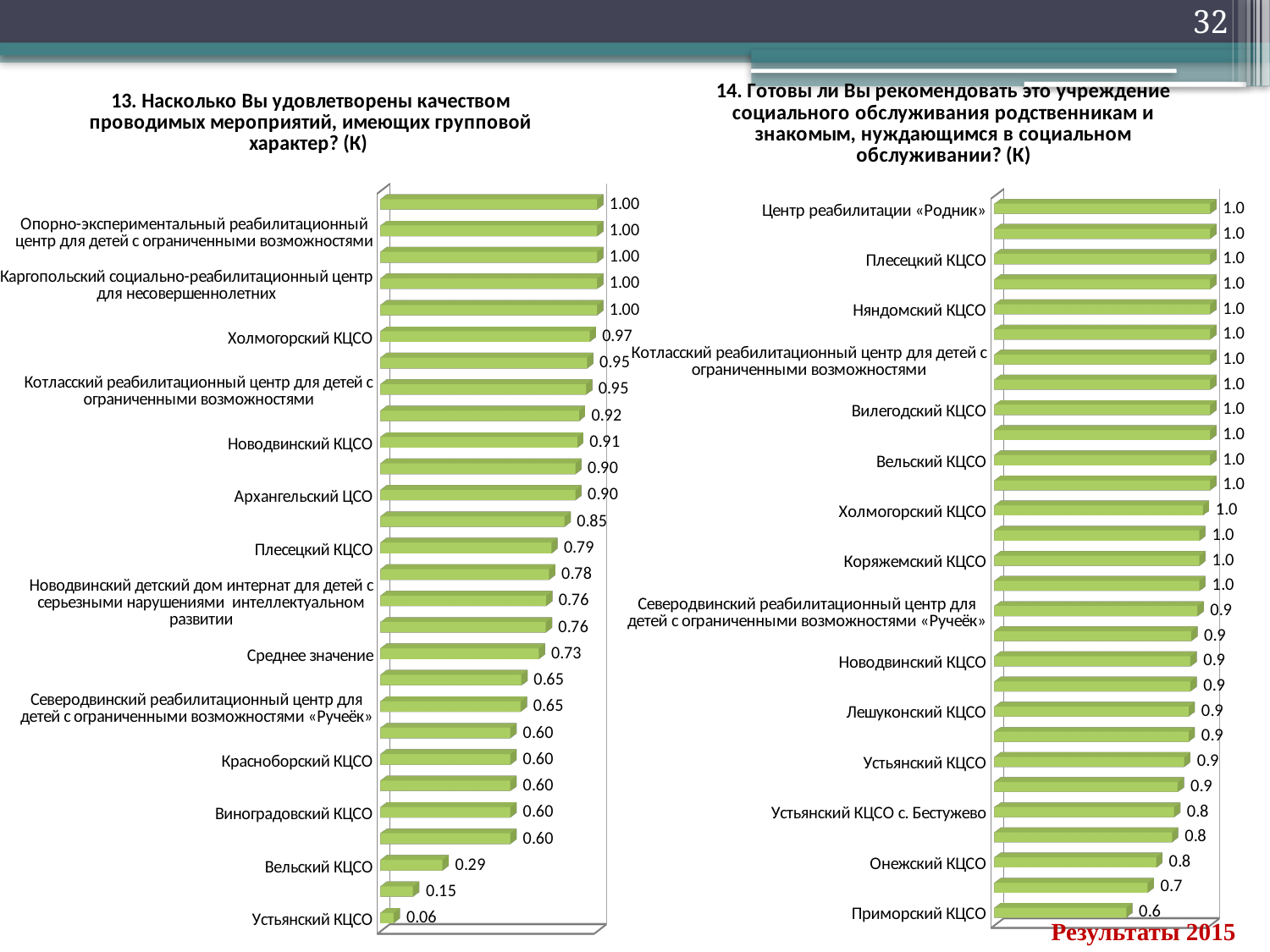
In the left chart (question 13), which has the larger value: Плесецкий КЦСО or Архангельский ЦСО? Архангельский ЦСО In the left chart (question 13), what is the difference between the values for Холмогорский КЦСО and Вельский КЦСО? 0.68 In the right chart (question 14), what is the difference between the values for Центр реабилитации «Родник» and Приморский КЦСО? 0.4 In the left chart (question 13), what is the value for Устьянский КЦСО? 0.06 In the left chart (question 13), what is the value for Вельский КЦСО? 0.29 In the right chart (question 14), what is the value for Онежский КЦСО? 0.8 What kind of chart is used for question 13 on the left side of the slide? bar chart In the left chart (question 13), what is the value labelled Среднее значение? 0.73 In the right chart (question 14), what is the value for Центр реабилитации «Родник»? 1.0 In the right chart (question 14), what is the value for Приморский КЦСО? 0.6 In the right chart (question 14), which labelled institution has the lowest value? Приморский КЦСО In the left chart (question 13), which labelled institution has the lowest value? Устьянский КЦСО